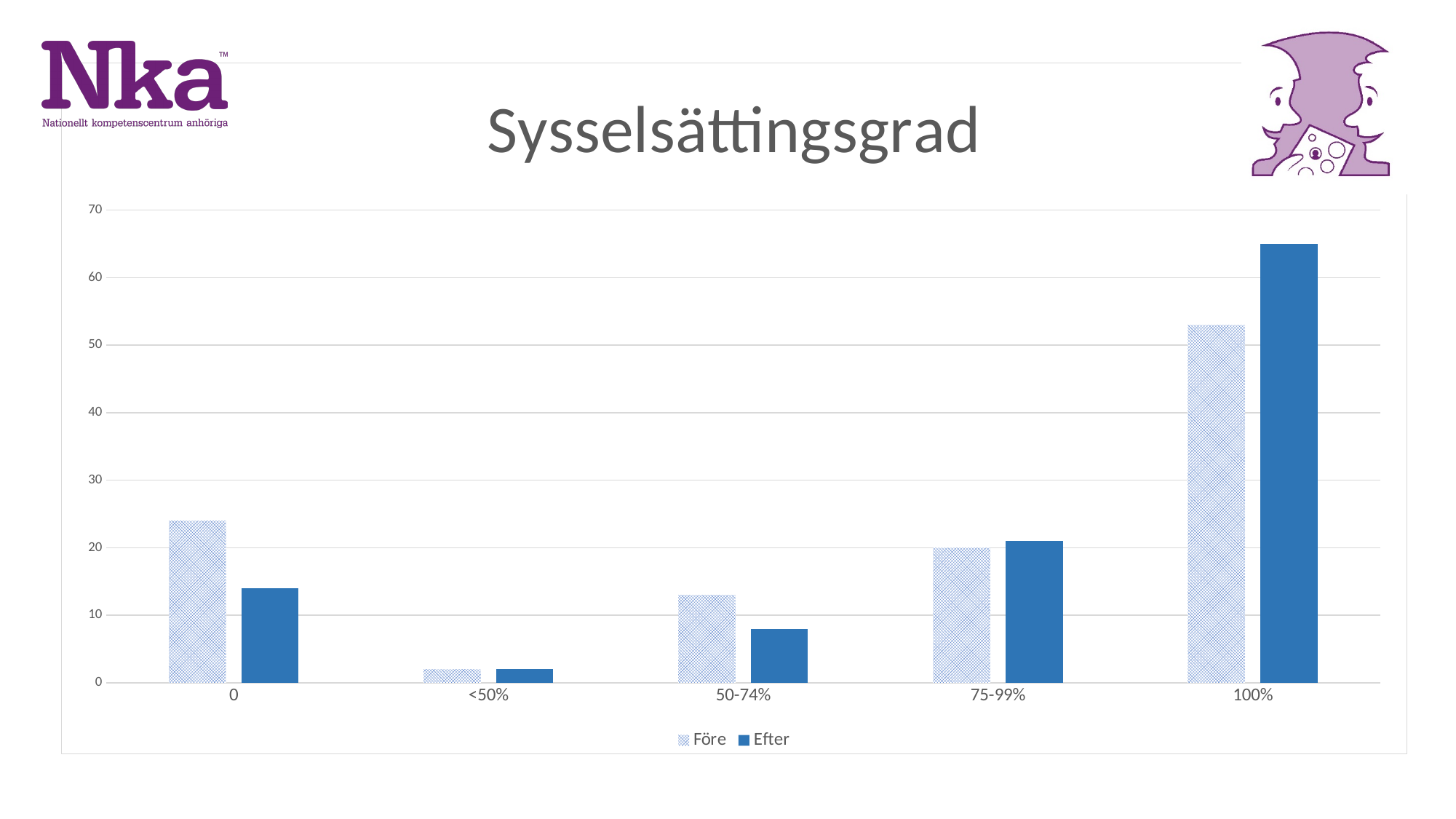
What is the title of the chart? Sysselsättingsgrad Is the Före value for 100% greater or less than 50? greater For the category 100%, which series has the larger value, Före or Efter? Efter Is the Efter value for 0 greater or less than 20? less For the category 0, which series has the larger value, Före or Efter? Före Which category has the lowest value for the Före series? <50% How many series does the legend list? 2 Which category has the highest value for the Efter series? 100% Is the Före value for 50-74% greater or less than 10? greater How many categories are shown on the x axis? 5 What kind of chart is shown on the slide? bar chart